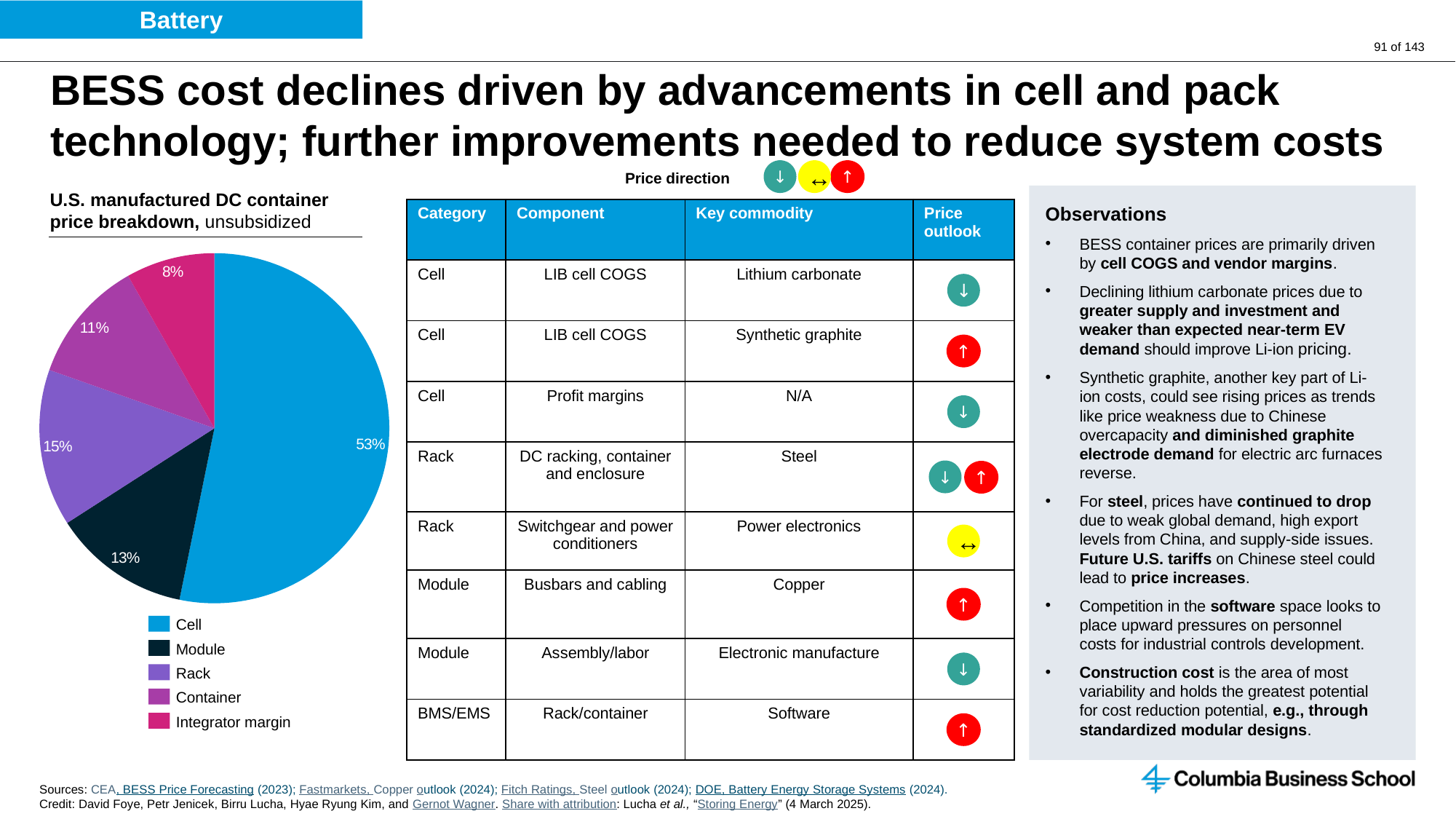
What type of chart is used to show the U.S. manufactured DC container price breakdown? Pie chart What share of the pie chart does Module account for? 13% What share of the pie chart is Integrator margin? 8% What is the difference in percentage points between the Cell share and the Rack share? 38 What share of the U.S. manufactured DC container price breakdown is attributed to Cell? 53% What is the title of the pie chart on the slide? U.S. manufactured DC container price breakdown, unsubsidized Which category has the smallest share in the pie chart? Integrator margin What percentage of the DC container price breakdown is Rack? 15% What is the combined share of Module and Container in the pie chart? 24% How many categories does the pie chart legend list? 5 Which has a larger share of the pie chart, Rack or Container? Rack Which category has the largest share in the pie chart? Cell